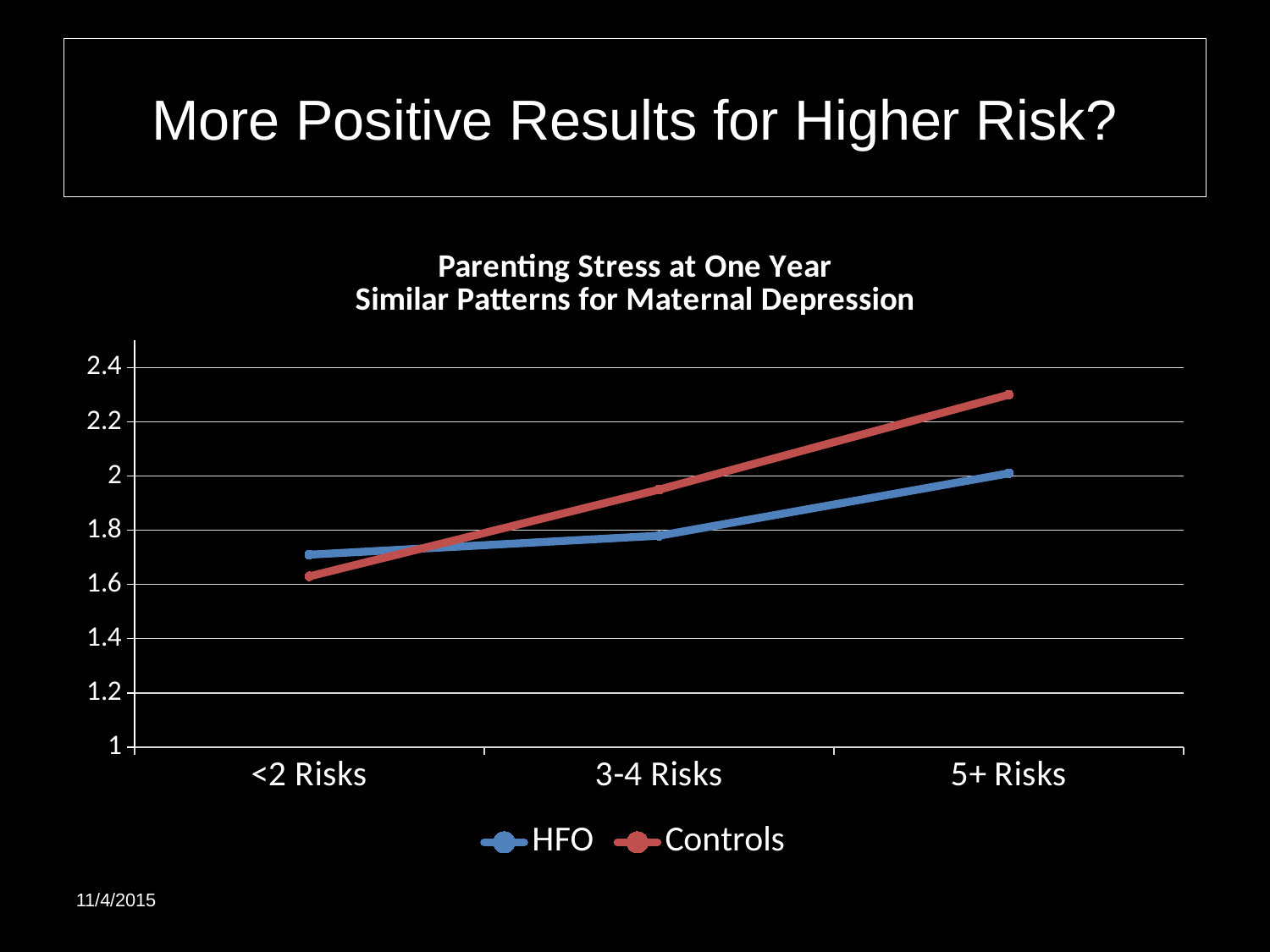
Which series is shown in red? Controls Is the value for Controls at <2 Risks greater or less than 1.8? less Is the value for Controls at 3-4 Risks greater or less than 1.8? greater Is the value for Controls at 5+ Risks greater or less than 2.2? greater What is the title of the chart? Parenting Stress at One Year Similar Patterns for Maternal Depression At <2 Risks, which series has the higher value, HFO or Controls? HFO How many series does the legend list? 2 What kind of chart is shown on the slide? line chart Do the values for the Controls series rise or fall from <2 Risks to 5+ Risks? rise At 5+ Risks, which series has the higher value, HFO or Controls? Controls How many risk categories are shown on the x axis? 3